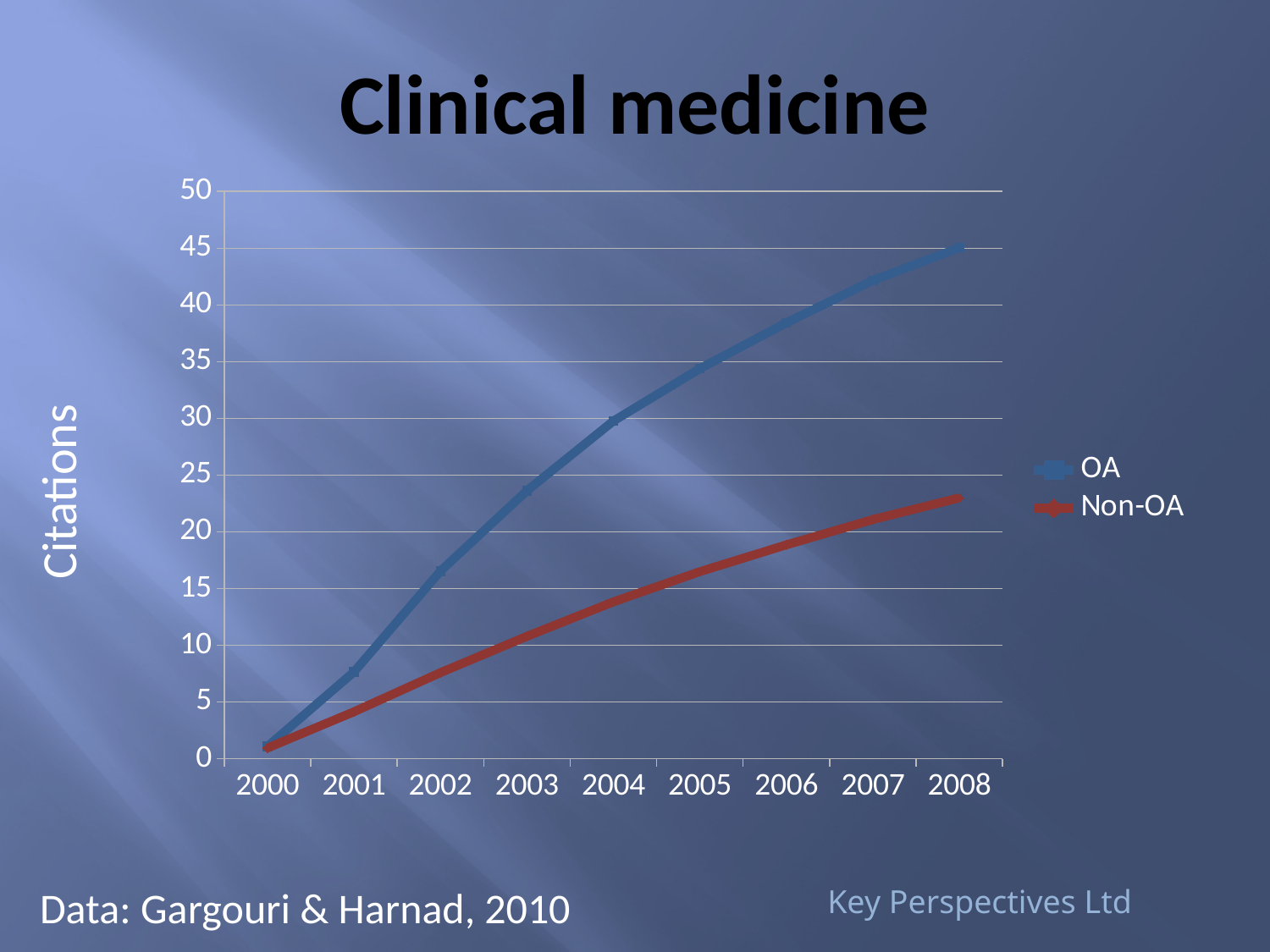
What are the two series named in the legend? OA and Non-OA What is the label of the vertical axis? Citations How many series does the legend list? 2 What kind of chart is shown on the slide? line chart Do the OA citations rise or fall from 2000 to 2008? rise Is the Non-OA value for 2008 greater or less than 25? less Which series has the higher value in 2006, OA or Non-OA? OA Is the Non-OA value for 2003 greater or less than 15? less Is the OA value for 2002 greater or less than 15? greater How many years are shown along the x axis? 9 In which year does the Non-OA series reach its highest value? 2008